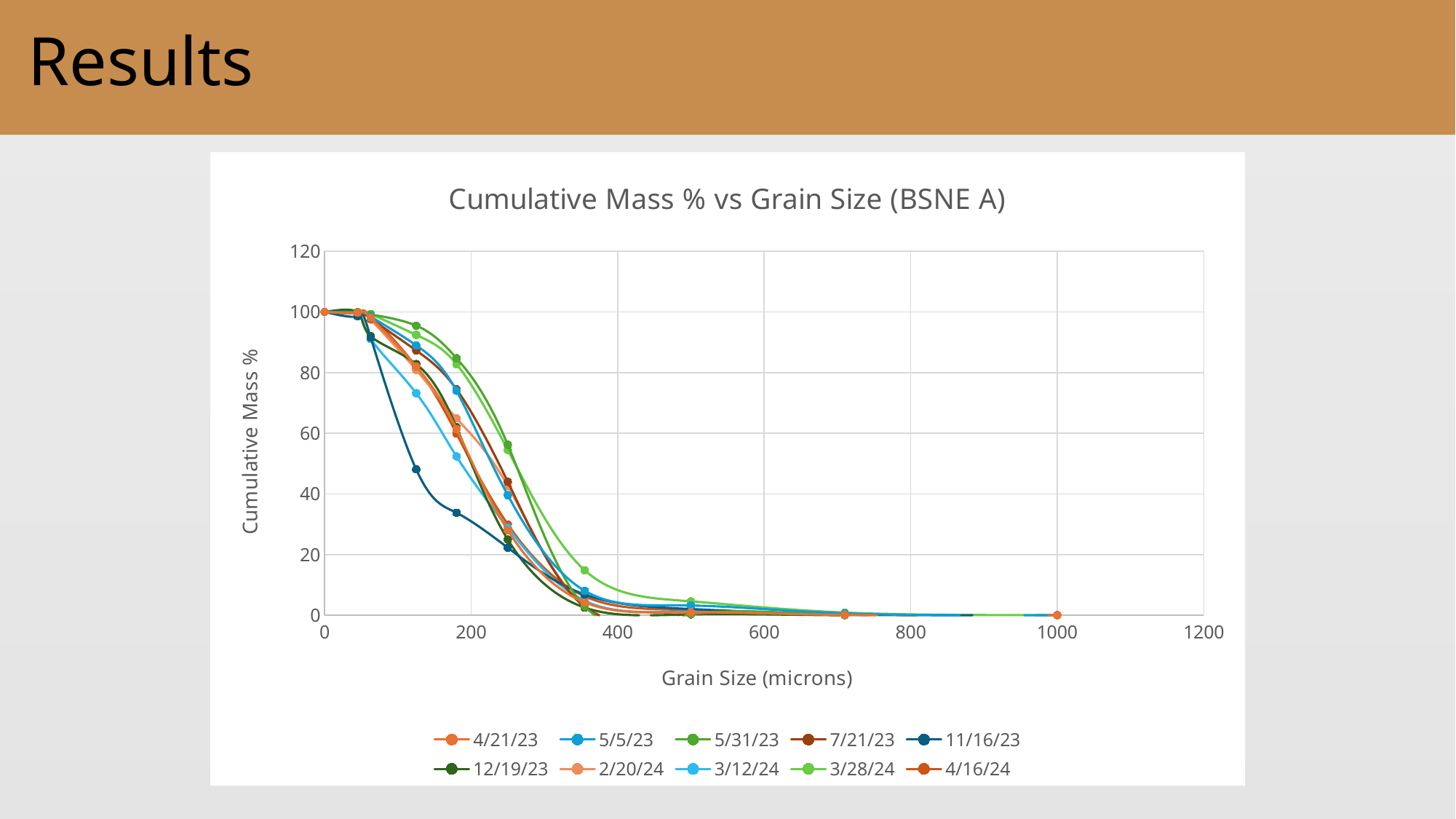
At about 125 microns, which series has the larger value: 11/16/23 or 5/31/23? 5/31/23 Is the value for the 11/16/23 series at about 180 microns greater or less than 40? less Is the value for the 11/16/23 series at about 125 microns greater or less than 60? less Do the cumulative mass % values rise or fall as grain size increases? fall What is the title of the chart? Cumulative Mass % vs Grain Size (BSNE A) Which series has the lowest cumulative mass % at about 125 microns? 11/16/23 How many series does the legend list? 10 What cumulative mass % do all series show at a grain size of 0 microns? 100 What kind of chart is shown on the slide? line chart What is the label of the x axis? Grain Size (microns) Which series has the highest cumulative mass % at about 360 microns? 3/28/24 Is the value for the 5/31/23 series at about 125 microns greater or less than 80? greater